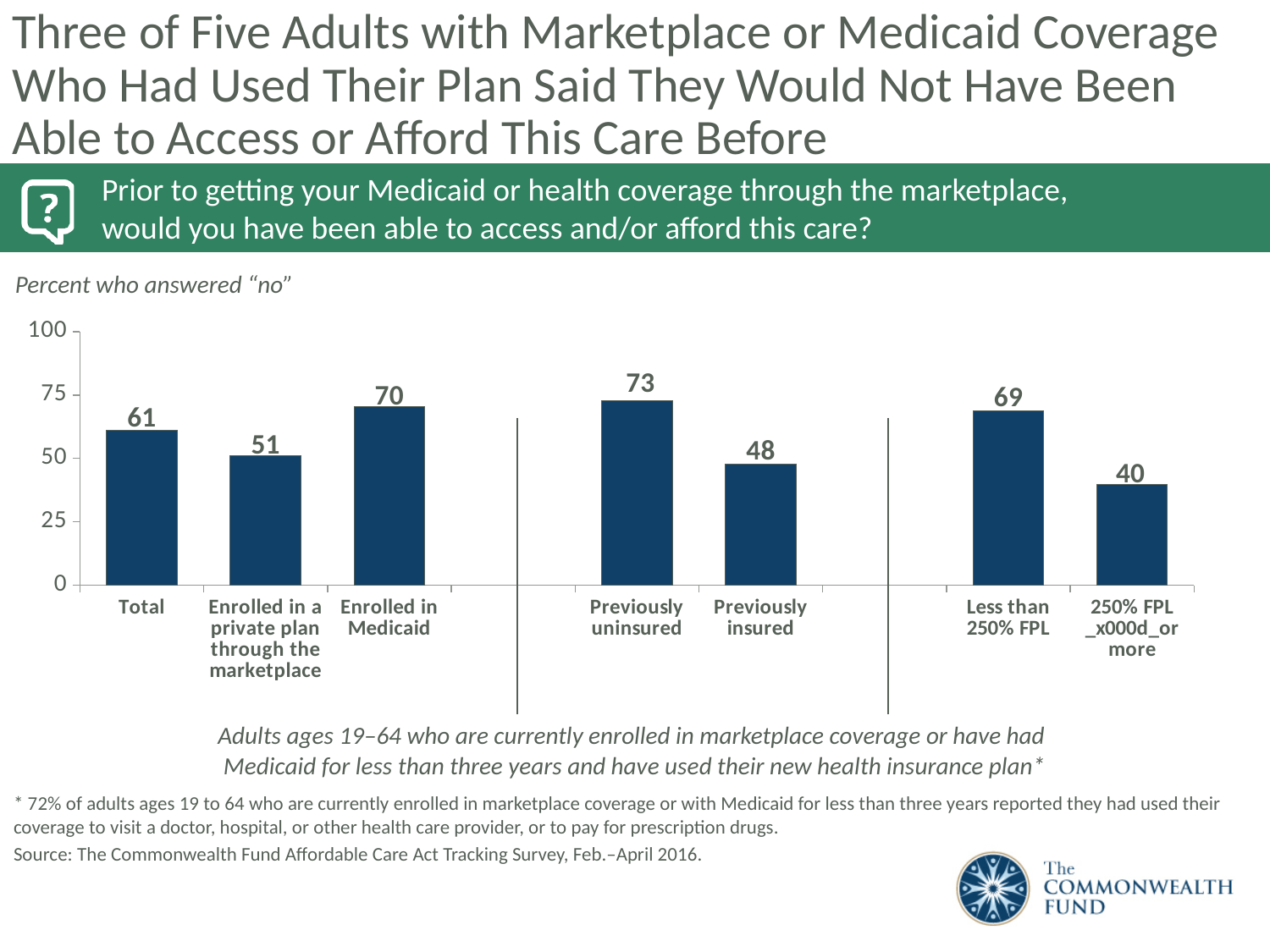
What does the label above the chart say the values represent? Percent who answered "no" How many bars are plotted in the chart? 7 Which category has the highest value? Previously uninsured What is the value for Enrolled in Medicaid? 70 What is the value for Less than 250% FPL? 69 What is the value for Previously uninsured? 73 What is the difference between the values for Previously uninsured and Previously insured? 25 Which category has the lowest value? 250% FPL or more Is the value for Previously insured greater or less than 50? less What is the value for Total? 61 Which is larger, the value for Enrolled in Medicaid or the value for Enrolled in a private plan through the marketplace? Enrolled in Medicaid What kind of chart is shown on the slide? bar chart